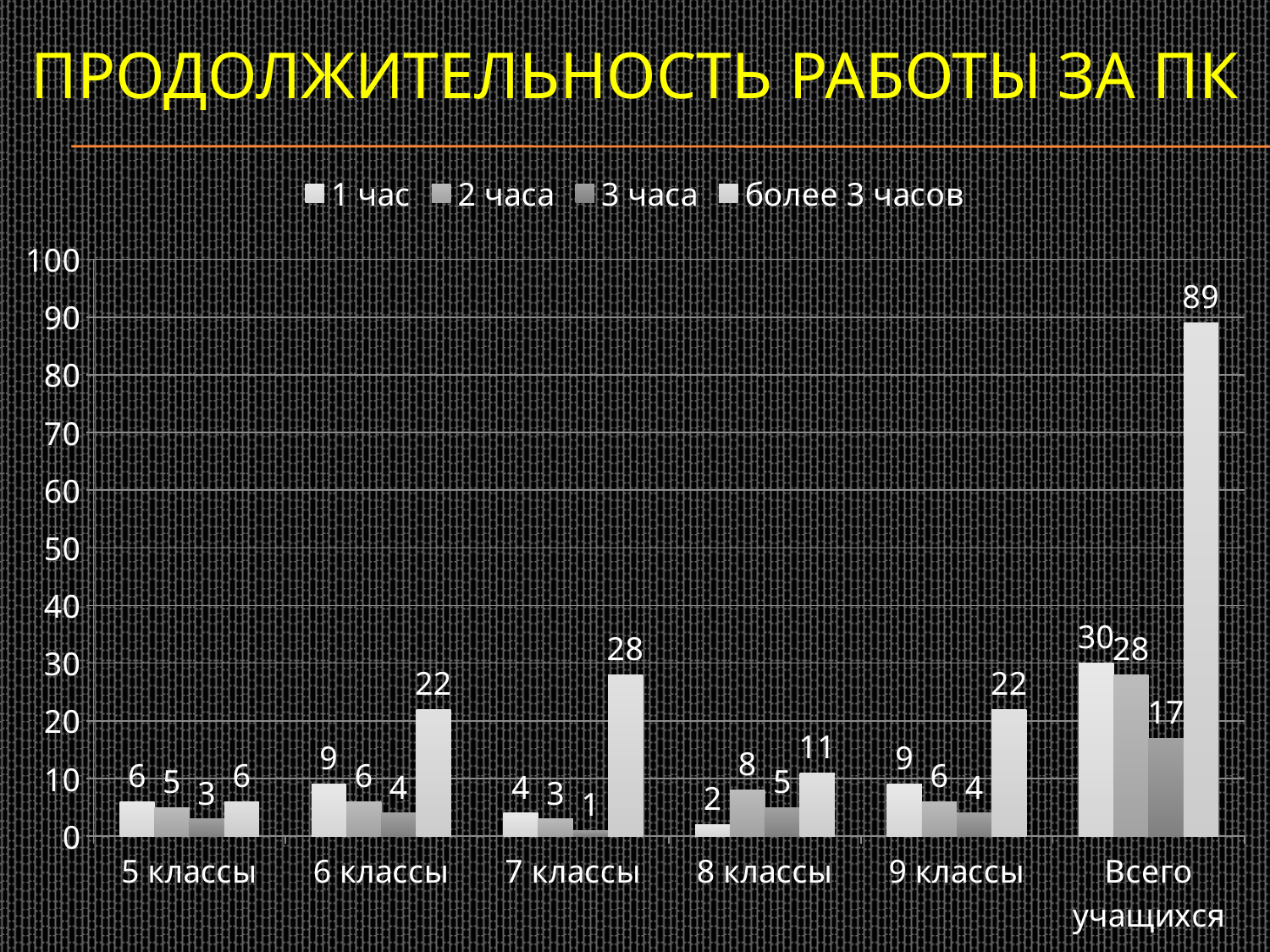
What type of chart is shown on the slide? bar chart Which is larger in the "7 классы" category: "1 час" or "более 3 часов"? более 3 часов How many categories are shown on the x axis? 6 What is the difference between "1 час" and "3 часа" in the "Всего учащихся" category? 13 What is the value for "более 3 часов" in the "Всего учащихся" category? 89 What is the value for "3 часа" in the "7 классы" category? 1 What is the value for "1 час" in the "6 классы" category? 9 What is the value for "2 часа" in the "8 классы" category? 8 What is the title of the chart on the slide? ПРОДОЛЖИТЕЛЬНОСТЬ РАБОТЫ ЗА ПК How many series does the legend list? 4 Which category has the lowest value for "1 час"? 8 классы Which category has the highest value for "более 3 часов"? Всего учащихся